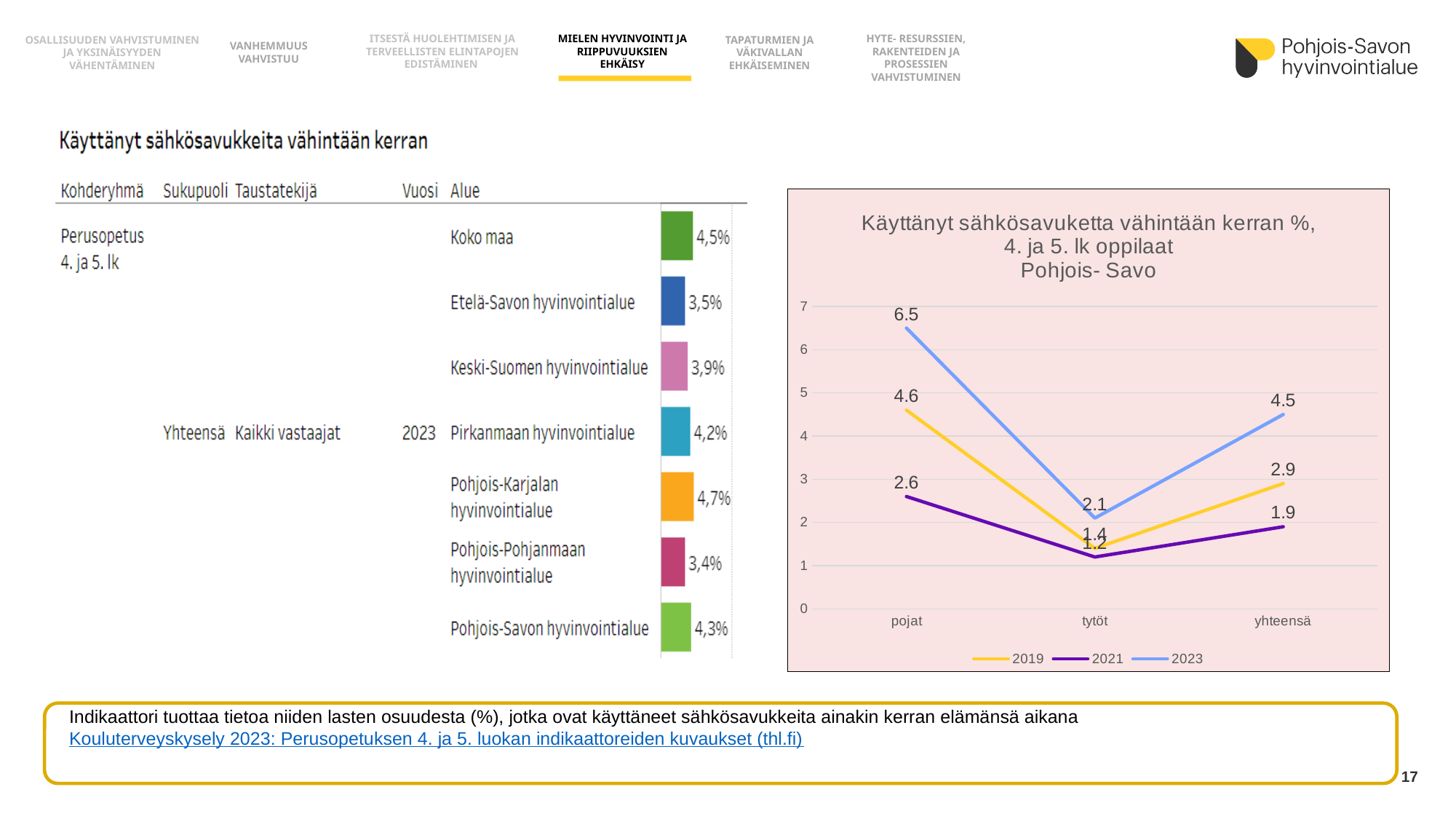
In the bar chart on the left, which region has the highest value? Pohjois-Karjalan hyvinvointialue In the line chart on the right, what is the 2019 value for yhteensä? 2.9 In the bar chart on the left, which region has the lowest value? Pohjois-Pohjanmaan hyvinvointialue In the line chart on the right, what is the 2021 value for tytöt? 1.2 In the bar chart on the left, what is the value for Pohjois-Savon hyvinvointialue? 4,3% In the line chart on the right, how many series does the legend list? 3 In the line chart on the right, what is the difference between the 2023 and 2019 values for yhteensä? 1.6 In the bar chart on the left, how many regions are shown? 7 In the line chart on the right, what is the 2023 value for pojat? 6.5 In the line chart on the right, which category has the highest value for the 2023 series? pojat What kind of chart is the chart on the right? line chart In the line chart on the right, which is larger for tytöt: the 2019 value or the 2023 value? 2023